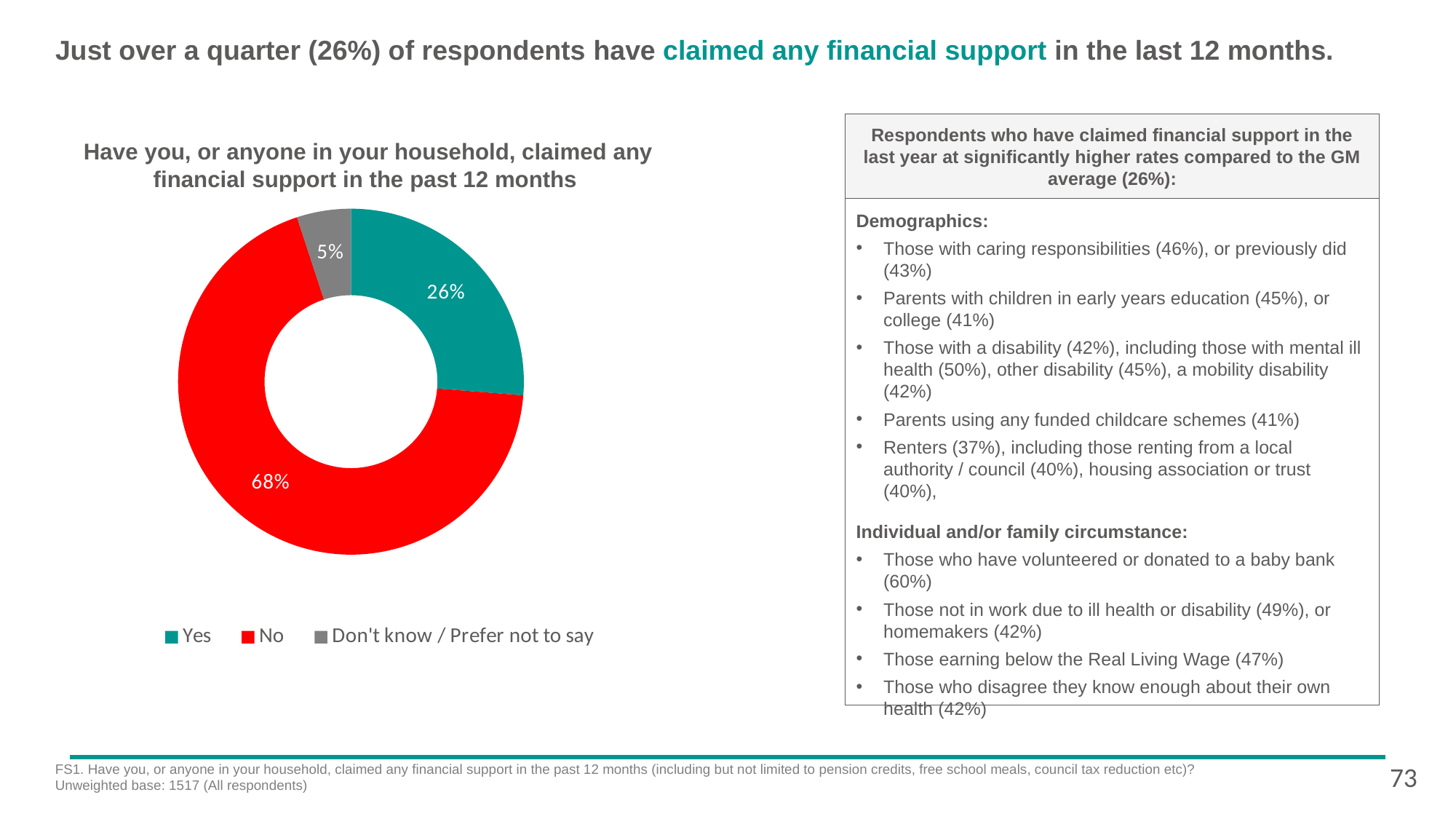
What percentage of respondents answered "Yes" to having claimed any financial support in the past 12 months? 26% What type of chart is shown on the slide? Pie chart (doughnut) How many response categories are shown in the chart? 3 Which response category has the smallest share of the chart? Don't know / Prefer not to say Which is larger, the share for "Yes" or the share for "Don't know / Prefer not to say"? Yes What is the title of the chart? Have you, or anyone in your household, claimed any financial support in the past 12 months What percentage of respondents answered "No" in the chart? 68% What is the difference in percentage points between the "No" and "Yes" shares? 42 What colour represents the "No" category in the chart? Red What percentage of respondents answered "Don't know / Prefer not to say"? 5% Which response category has the largest share of the chart? No How many entries does the chart legend list? 3